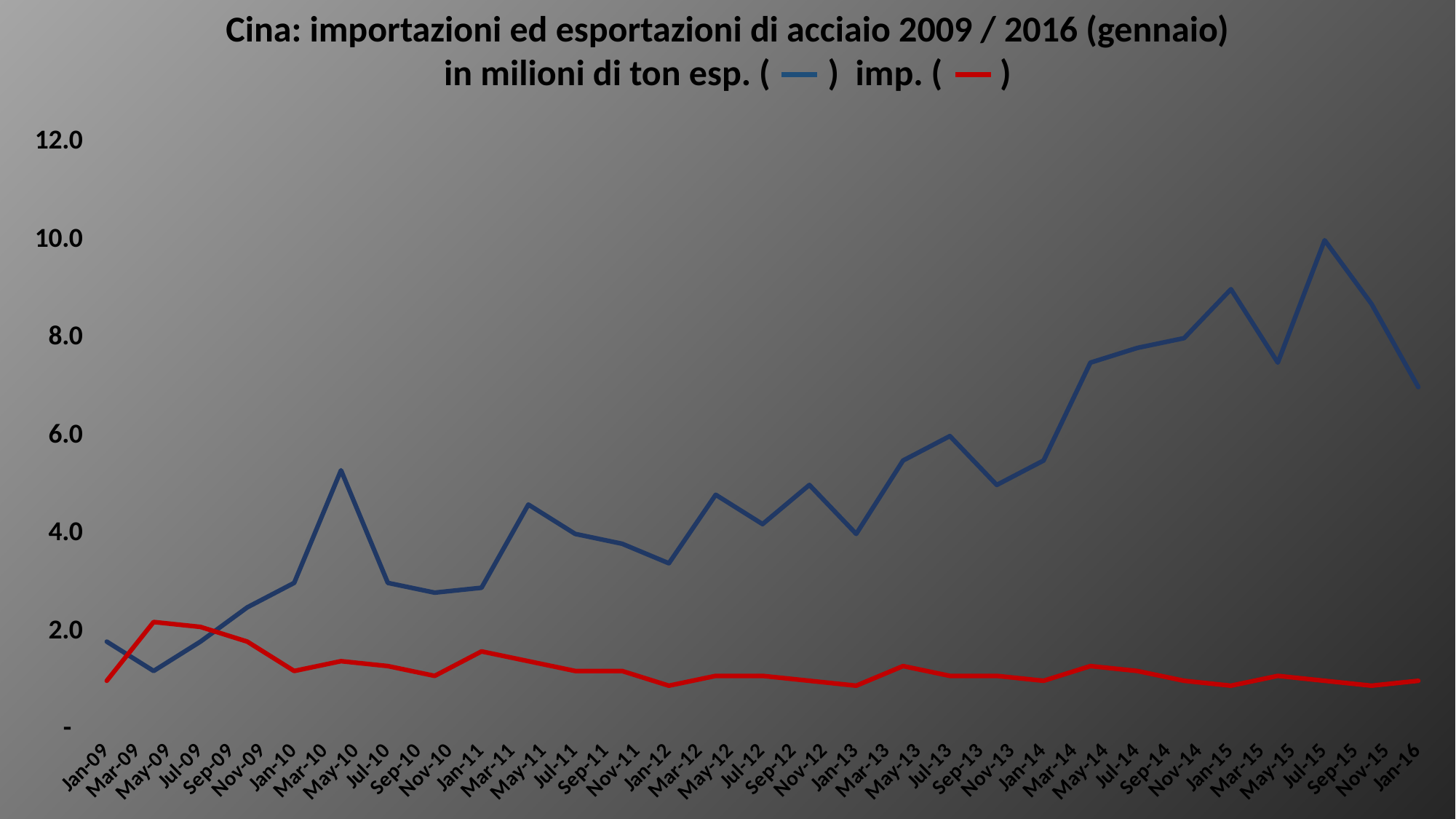
Is the value for imports (imp.) in Jan-16 greater or less than 2.0? less In May-09, which is larger: exports (esp.) or imports (imp.)? imports (imp.) What kind of chart is shown on the slide? line chart What unit of measure does the chart title state for the values? milioni di ton Is the value for exports (esp.) in Jan-16 greater or less than 6.0? greater In which month do exports (esp.) reach their highest value? Jul-15 Do exports (esp.) generally rise or fall from Jan-09 to Jan-16? rise Which colour is used for the exports (esp.) line? blue How many series does the chart plot? 2 Is the value for exports (esp.) in Jul-15 greater or less than 8.0? greater